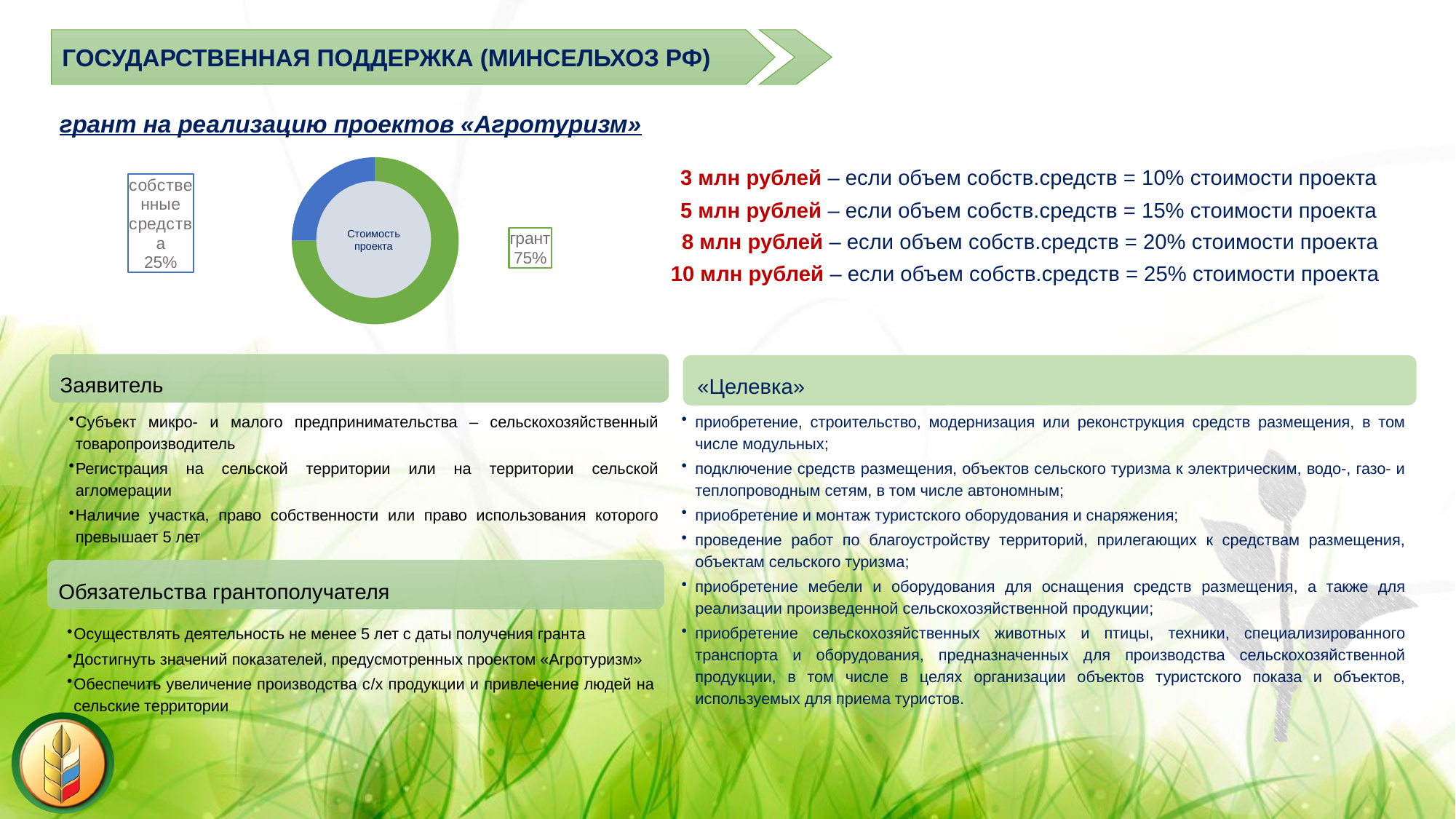
Which slice of the doughnut chart is the smallest? собственные средства Which slice of the doughnut chart is the largest? грант What kind of chart is shown on the slide? doughnut chart Is the share of the собственные средства slice greater or less than 50%? less What share of the doughnut chart is labelled "грант"? 75% What text is written in the centre of the doughnut chart? Стоимость проекта How many slices does the doughnut chart have? 2 What colour is the грант slice of the doughnut chart? green What share of the doughnut chart is labelled "собственные средства"? 25% What is the difference in percentage points between the грант slice and the собственные средства slice? 50 Which is larger in the doughnut chart: грант or собственные средства? грант